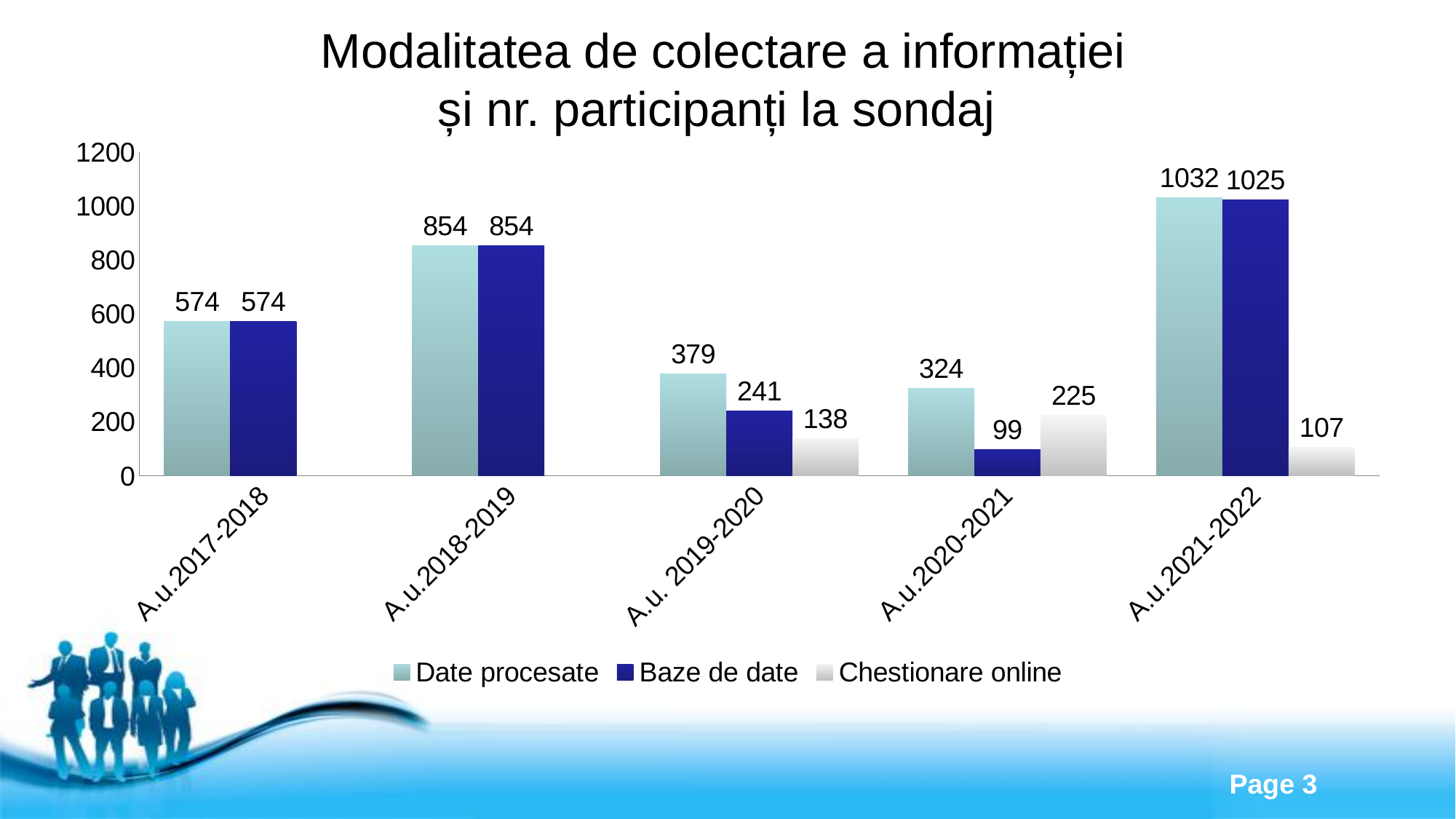
How many series does the legend list? 3 Which is larger for A.u.2020-2021: Baze de date or Chestionare online? Chestionare online What is the value of Baze de date for A.u.2020-2021? 99 What is the value of Chestionare online for A.u. 2019-2020? 138 What is the value of Date procesate for A.u.2021-2022? 1032 How many categories are shown on the x axis? 5 What is the difference between Date procesate and Baze de date for A.u.2021-2022? 7 Which category has the lowest value for Baze de date? A.u.2020-2021 What kind of chart is shown on the slide? bar chart What is the title of the chart? Modalitatea de colectare a informației și nr. participanți la sondaj Which category has the highest value for Date procesate? A.u.2021-2022 What is the difference between Date procesate and Baze de date for A.u. 2019-2020? 138